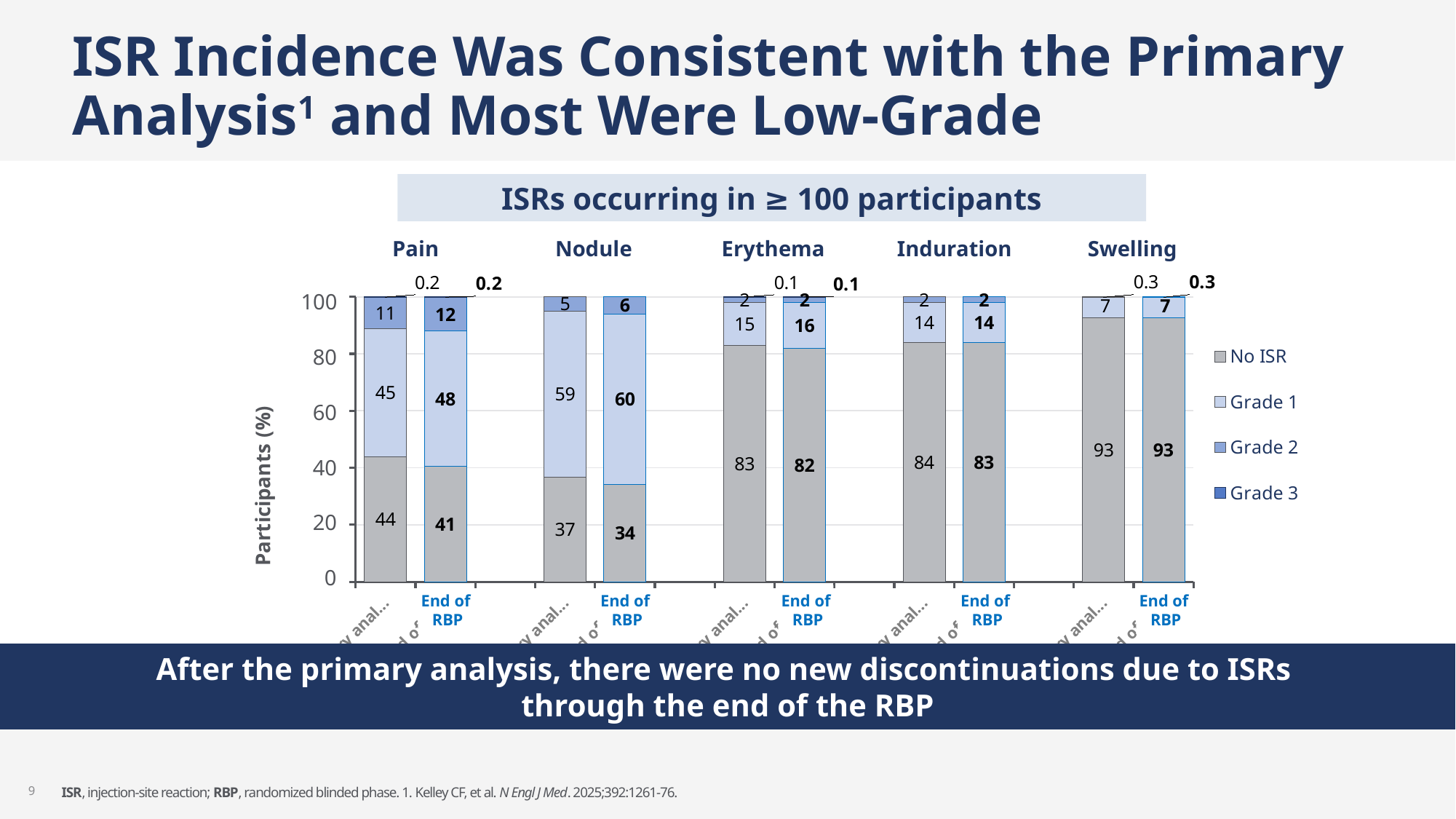
What is the Grade 2 value for the End of RBP bar under Erythema? 2 How many ISR types are shown along the x axis of the chart? 5 Which is larger at End of RBP: the Grade 1 value for Pain or the Grade 1 value for Nodule? Nodule What is the Grade 1 value for the End of RBP bar under Nodule? 60 What is the No ISR value for the End of RBP bar under Pain? 41 What kind of chart is shown on the slide? Stacked bar chart Which ISR type has the highest No ISR value in its End of RBP bar? Swelling What is the No ISR value for the left bar under Induration? 84 How many series does the chart legend list? 4 Which ISR type has the lowest No ISR value in its End of RBP bar? Nodule What is the difference between the Grade 1 value for Nodule and the Grade 1 value for Pain in the End of RBP bars? 12